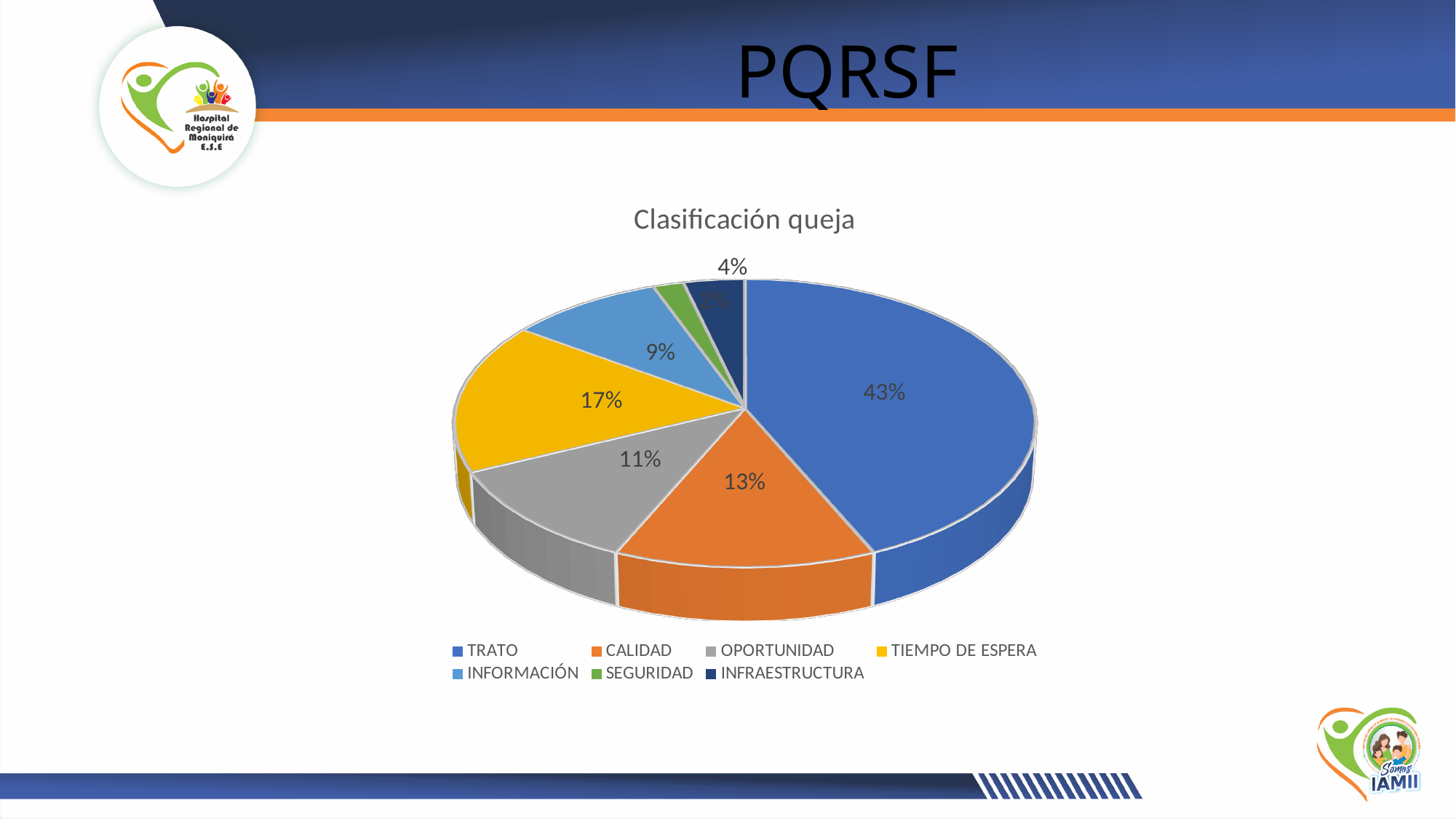
Which is larger, the share for OPORTUNIDAD or the share for CALIDAD? CALIDAD What percentage of the pie does TRATO represent? 43% What is the difference in percentage points between TRATO and TIEMPO DE ESPERA? 26 What percentage of the pie does INFORMACIÓN represent? 9% What percentage of the pie does CALIDAD represent? 13% What percentage of the pie does TIEMPO DE ESPERA represent? 17% What percentage of the pie does INFRAESTRUCTURA represent? 4% What is the title of the chart? Clasificación queja How many categories does the legend list? 7 Which category has the largest share of the pie? TRATO What type of chart is shown on the slide? pie chart Which category has the smallest share of the pie? SEGURIDAD